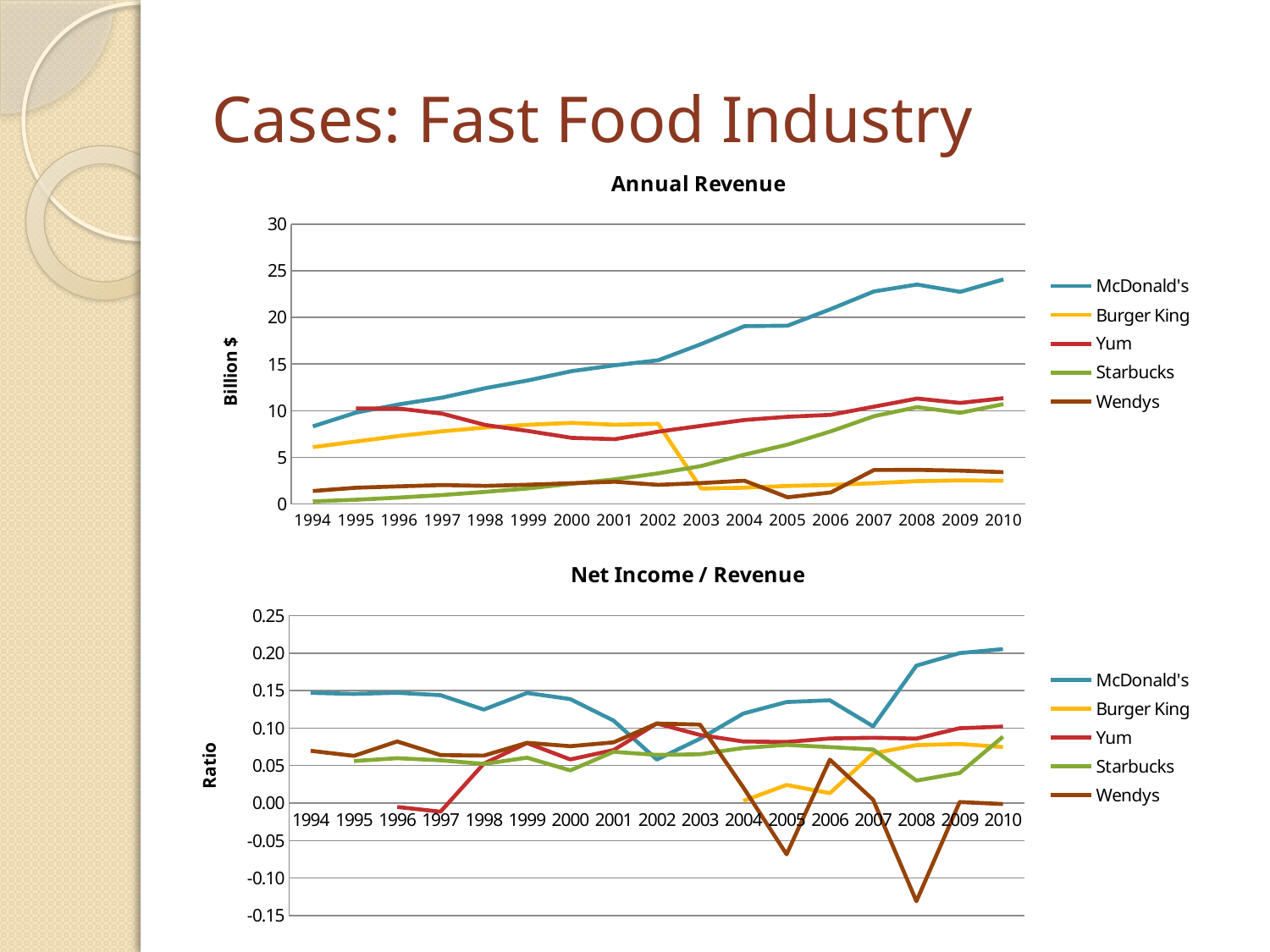
In the Annual Revenue chart, is the value for McDonald's in 2010 greater or less than 20? greater In the Annual Revenue chart, how many years are shown on the x axis? 17 In the Net Income / Revenue chart, what is the label on the y axis? Ratio In the Annual Revenue chart, is the value for Wendys in 2005 greater or less than 5? less In the Annual Revenue chart, which company has the highest revenue in 2010? McDonald's In the Annual Revenue chart, which company has the lowest revenue in 1994? Starbucks In the Annual Revenue chart, what kind of chart is shown? Line chart In the Net Income / Revenue chart, which company has the lowest ratio in 2008? Wendys In the Net Income / Revenue chart, is the value for McDonald's in 2010 greater or less than 0.15? greater In the Annual Revenue chart, does McDonald's revenue generally rise or fall from 1994 to 2010? Rise In the Annual Revenue chart, how many series does the legend list? 5 In the Annual Revenue chart, which is larger in 2010, Yum or Burger King? Yum